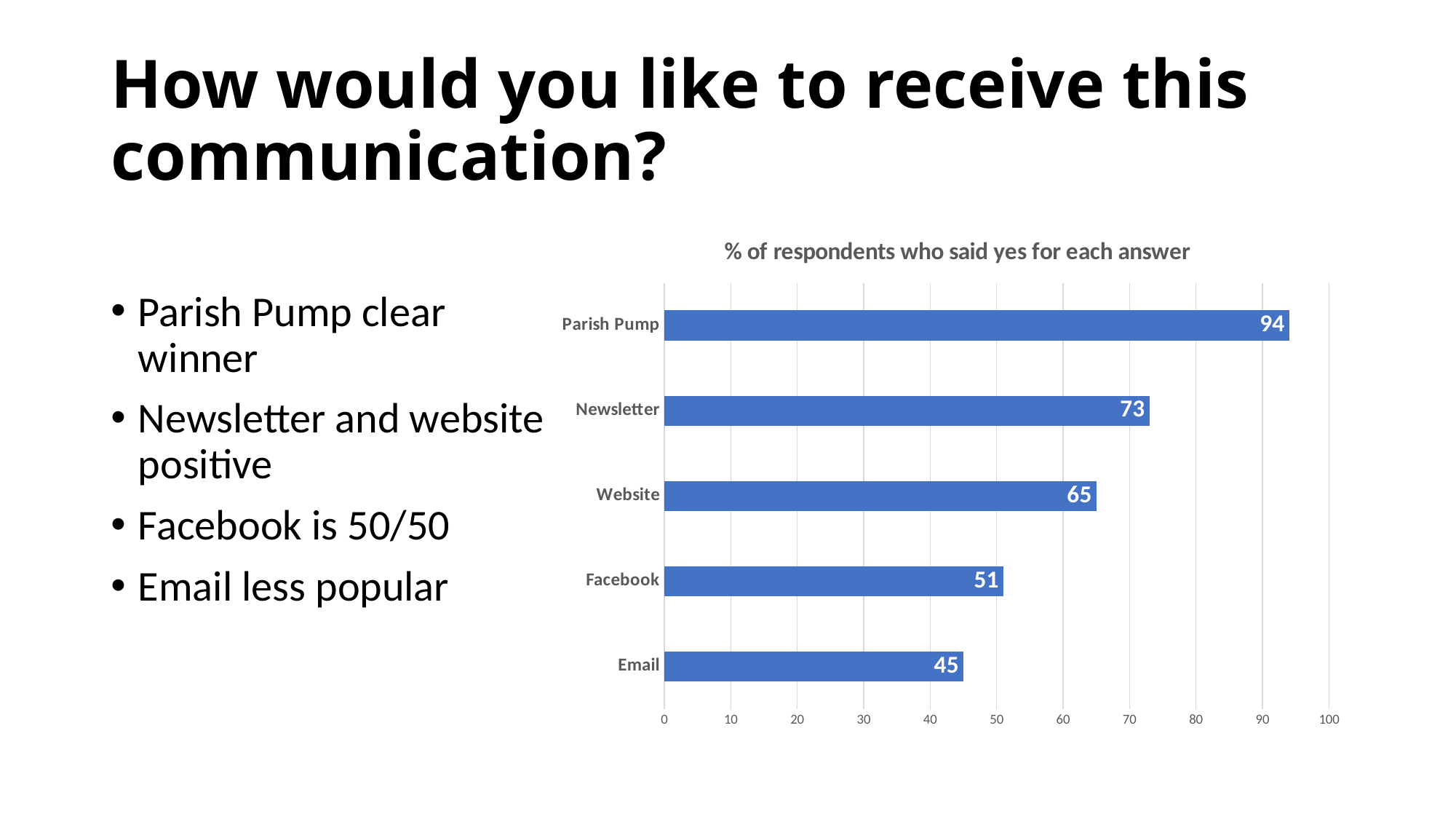
How many categories are shown in the chart? 5 What is the value for Parish Pump? 94 Which category has the lowest value? Email What is the title of the chart? % of respondents who said yes for each answer What is the difference between the values for Parish Pump and Email? 49 Which category has the highest value? Parish Pump What kind of chart is shown on the slide? Bar chart What is the value for Newsletter? 73 What is the value for Email? 45 Which is larger, the value for Newsletter or the value for Website? Newsletter What is the value for Facebook? 51 What is the value for Website? 65